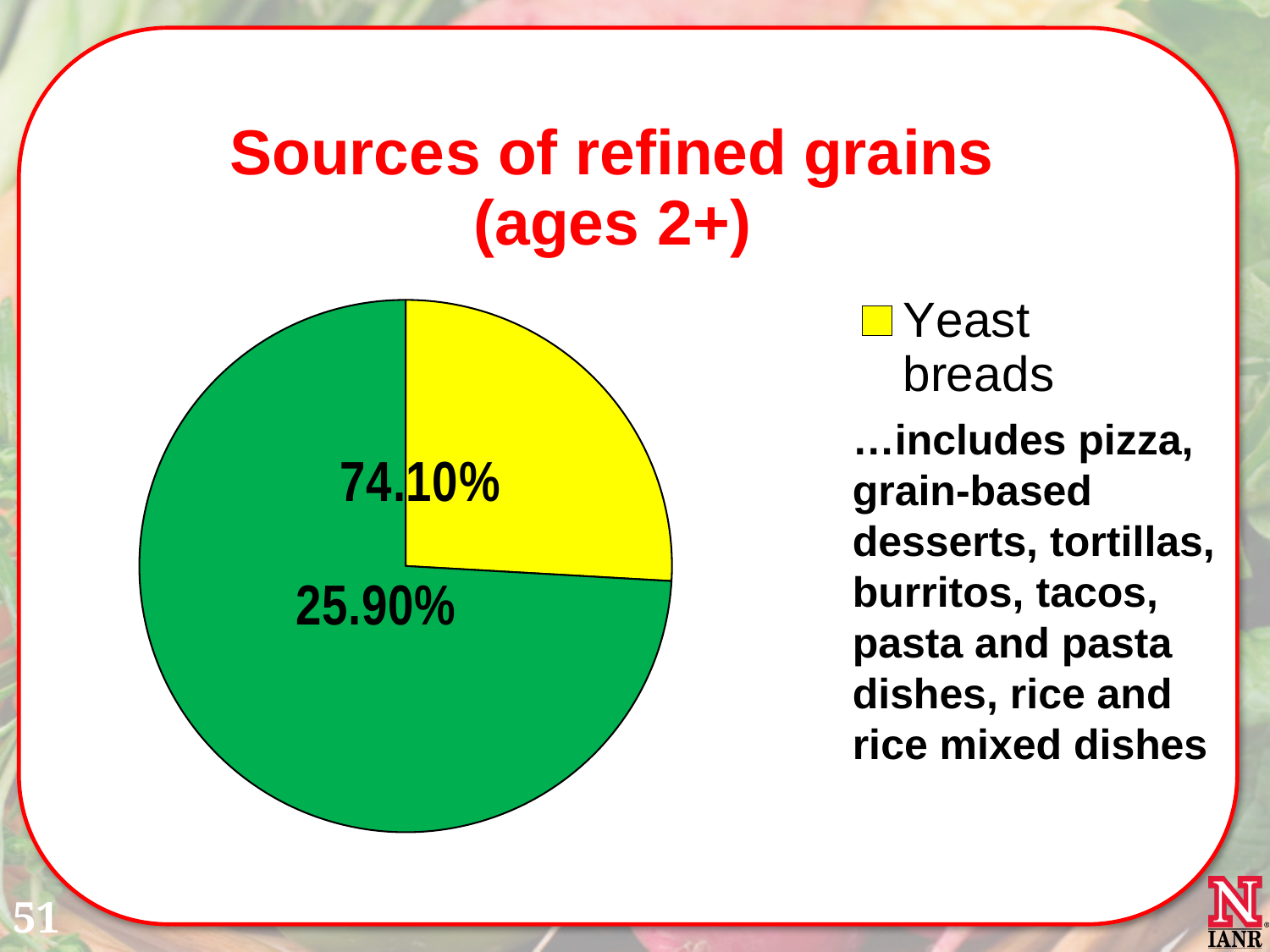
Is the Yeast breads slice larger or smaller than the other slice of the pie? smaller What type of chart is shown on the slide? pie chart What is the difference between the two percentages printed on the pie chart? 48.20% Does the yellow slice of the pie chart represent more or less than half of the pie? less Which slice of the pie chart is larger, the yellow one or the green one? green What colour is used for the Yeast breads entry in the legend? yellow What do the two percentages printed on the pie chart add up to? 100.00% What is the title of the chart on the slide? Sources of refined grains (ages 2+) How many slices does the pie chart have? 2 What is the smaller of the two percentages printed on the pie chart? 25.90% How many entries does the legend of the pie chart list? 1 What is the larger of the two percentages printed on the pie chart? 74.10%